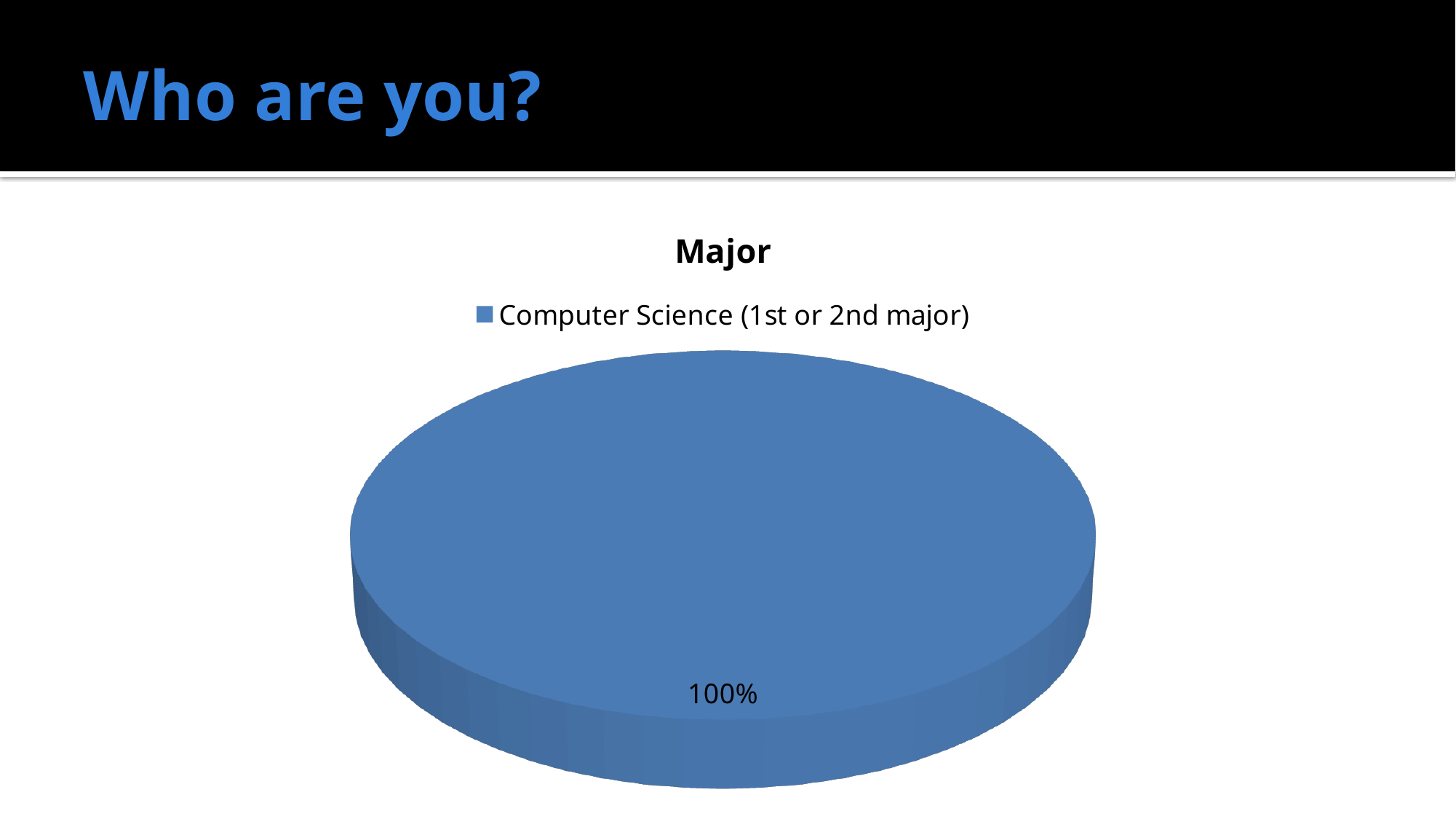
What value is printed on the slice for Computer Science (1st or 2nd major)? 100% What is the legend entry for the pie chart? Computer Science (1st or 2nd major) How many entries does the legend list? 1 Which category is the largest slice of the pie? Computer Science (1st or 2nd major) What kind of chart is shown on the slide? pie chart What is the title of the chart? Major How many categories does the pie chart show? 1 What share of the pie does Computer Science (1st or 2nd major) represent? 100%